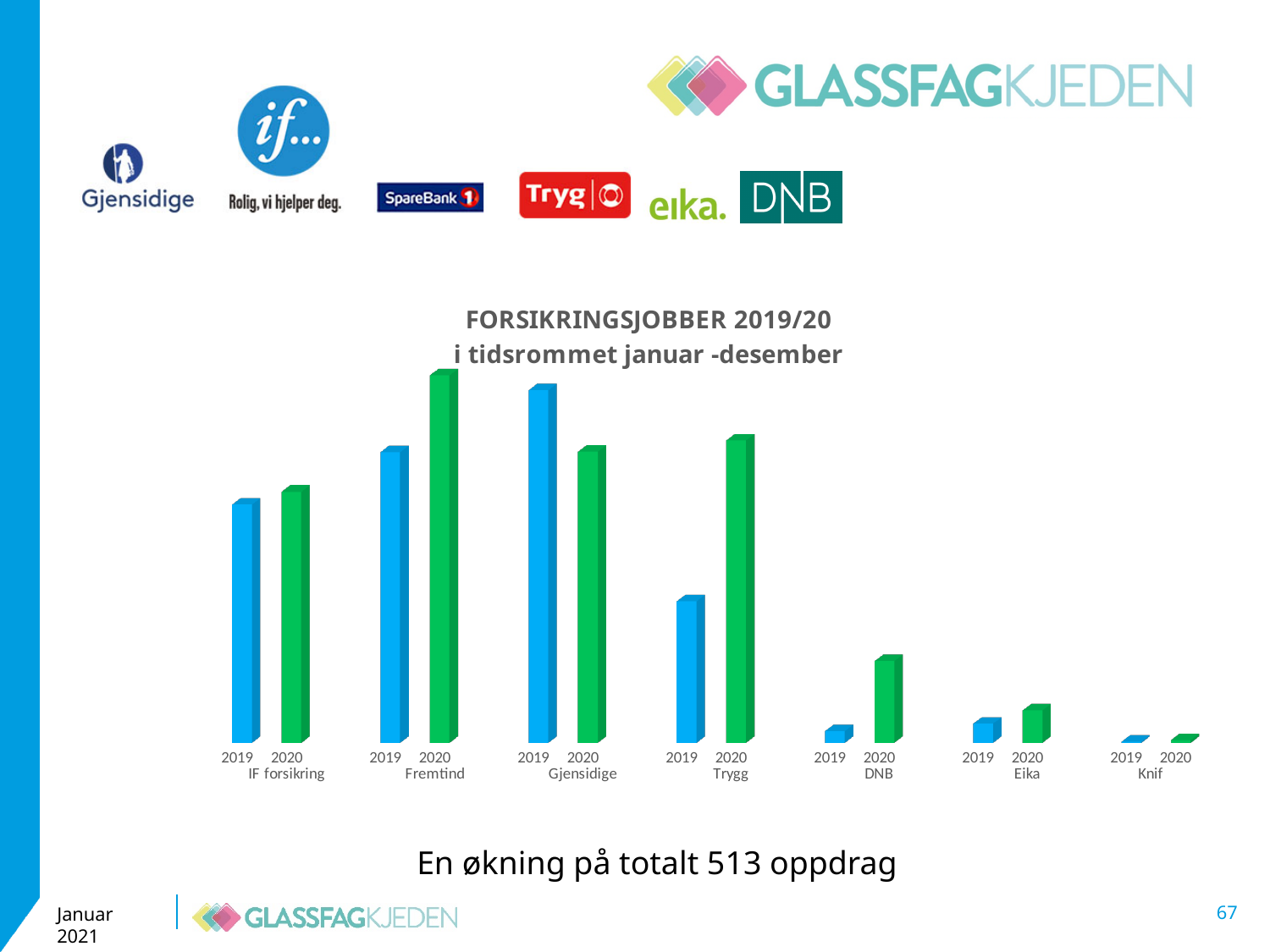
Did DNB's value rise or fall from 2019 to 2020? rise For Gjensidige, which year has the larger value, 2019 or 2020? 2019 Which company has the tallest 2020 bar? Fremtind Which company has the tallest 2019 bar? Gjensidige For Fremtind, which year has the larger value, 2019 or 2020? 2020 Which two years are compared for each company in the chart? 2019 and 2020 What kind of chart is shown on the slide? bar chart What is the title of the chart? FORSIKRINGSJOBBER 2019/20 i tidsrommet januar -desember For Trygg, which year has the larger value, 2019 or 2020? 2020 How many insurance companies are shown as categories on the chart? 7 What colour are the 2020 bars in the chart? green Which company has the lowest values in the chart? Knif